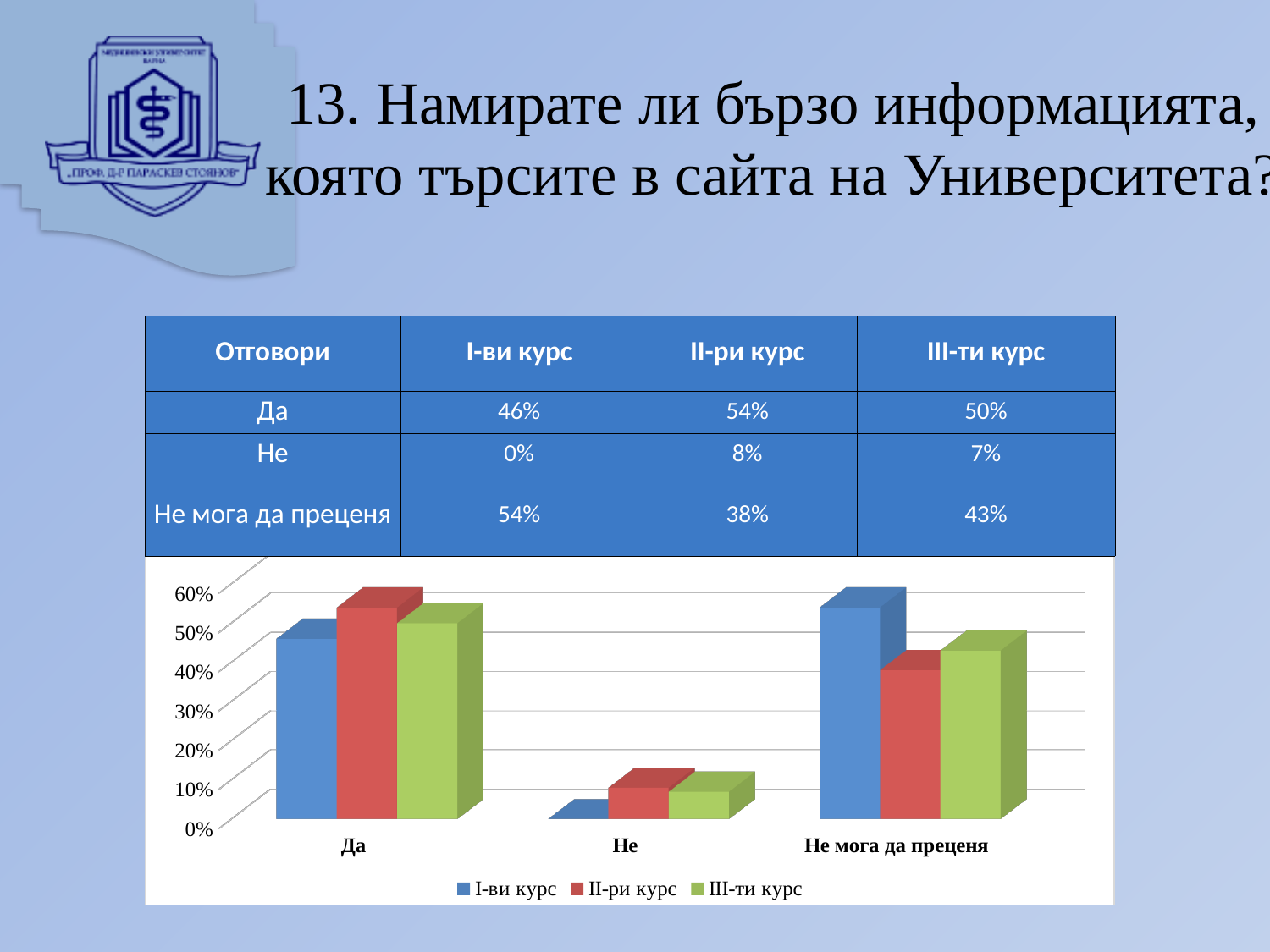
What type of chart is shown on the slide? bar chart Which colour represents II-ри курс in the chart? red Is the value for I-ви курс in the Не мога да преценя category greater or less than 50%? greater How many series does the chart legend list? 3 What is the difference between the I-ви курс and II-ри курс values in the Да category? 8% What is the value for II-ри курс in the Да category? 54% Which is larger: the III-ти курс value for Да or the III-ти курс value for Не мога да преценя? Да How many categories are shown on the x axis of the chart? 3 What is the value for III-ти курс in the Не category? 7% Which series has the highest value in the Да category? II-ри курс What is the value for I-ви курс in the Не мога да преценя category? 54% Which series has the lowest value in the Не мога да преценя category? II-ри курс